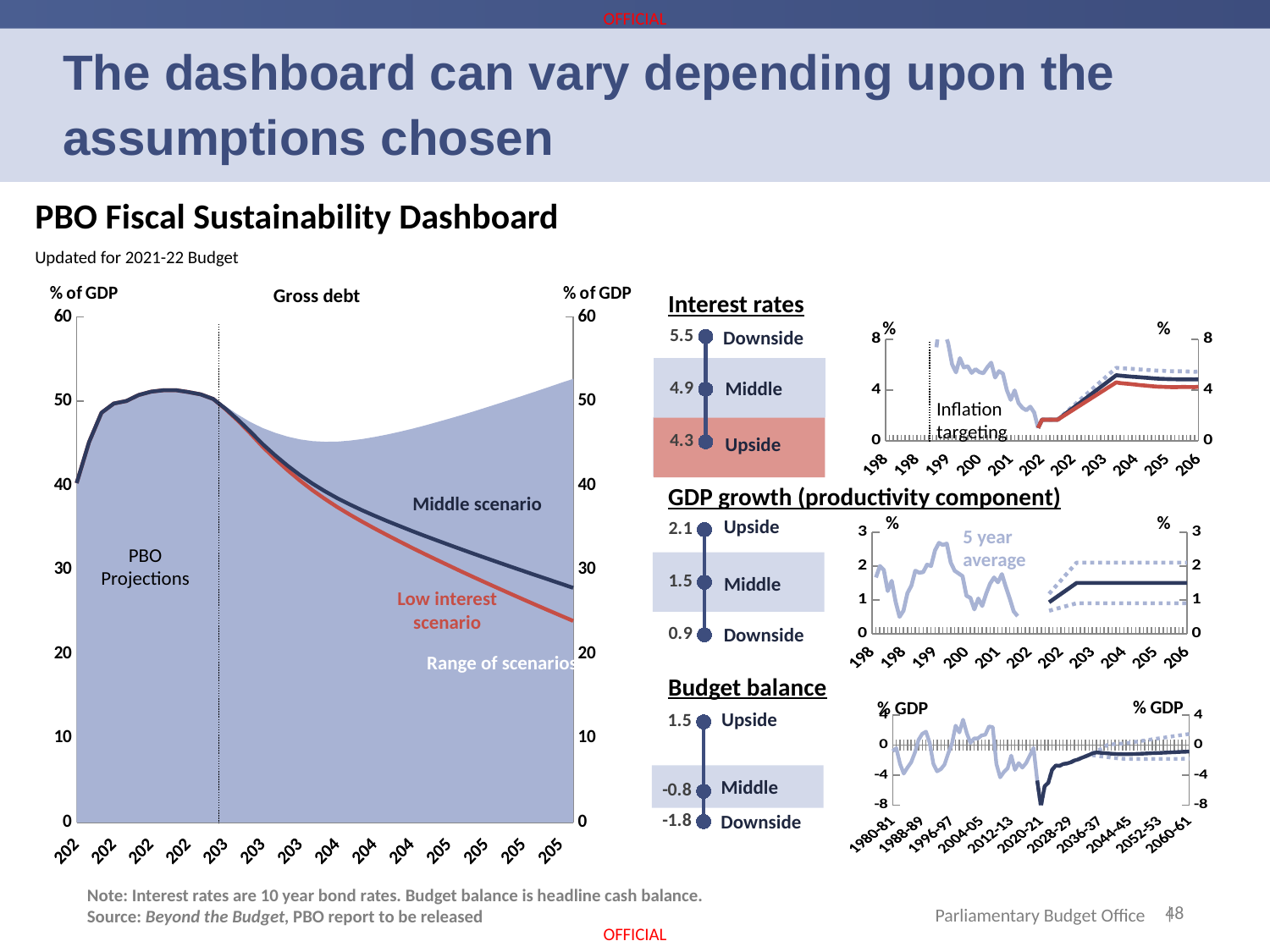
On the Budget balance panel, what is the Downside scenario value? -1.8 On the GDP growth (productivity component) panel, what is the Middle scenario value? 1.5 On the Budget balance panel, what is the Middle scenario value? -0.8 On the Interest rates panel, what is the Upside scenario value? 4.3 On the Gross debt chart, which scenario ends lower at the right-hand side: the Middle scenario or the Low interest scenario? Low interest scenario On the Gross debt chart, is the Middle scenario value at the end of the projection period greater or less than 30? less On the Interest rates panel, what is the Middle scenario value? 4.9 On the Interest rates panel, what is the difference between the Downside and Upside scenario values? 1.2 What unit is shown on the y axis of the Gross debt chart? % of GDP On the Budget balance panel, which scenario has the highest value? Upside On the GDP growth (productivity component) panel, what is the difference between the Upside and Downside scenario values? 1.2 On the Interest rates panel, what is the Downside scenario value? 5.5